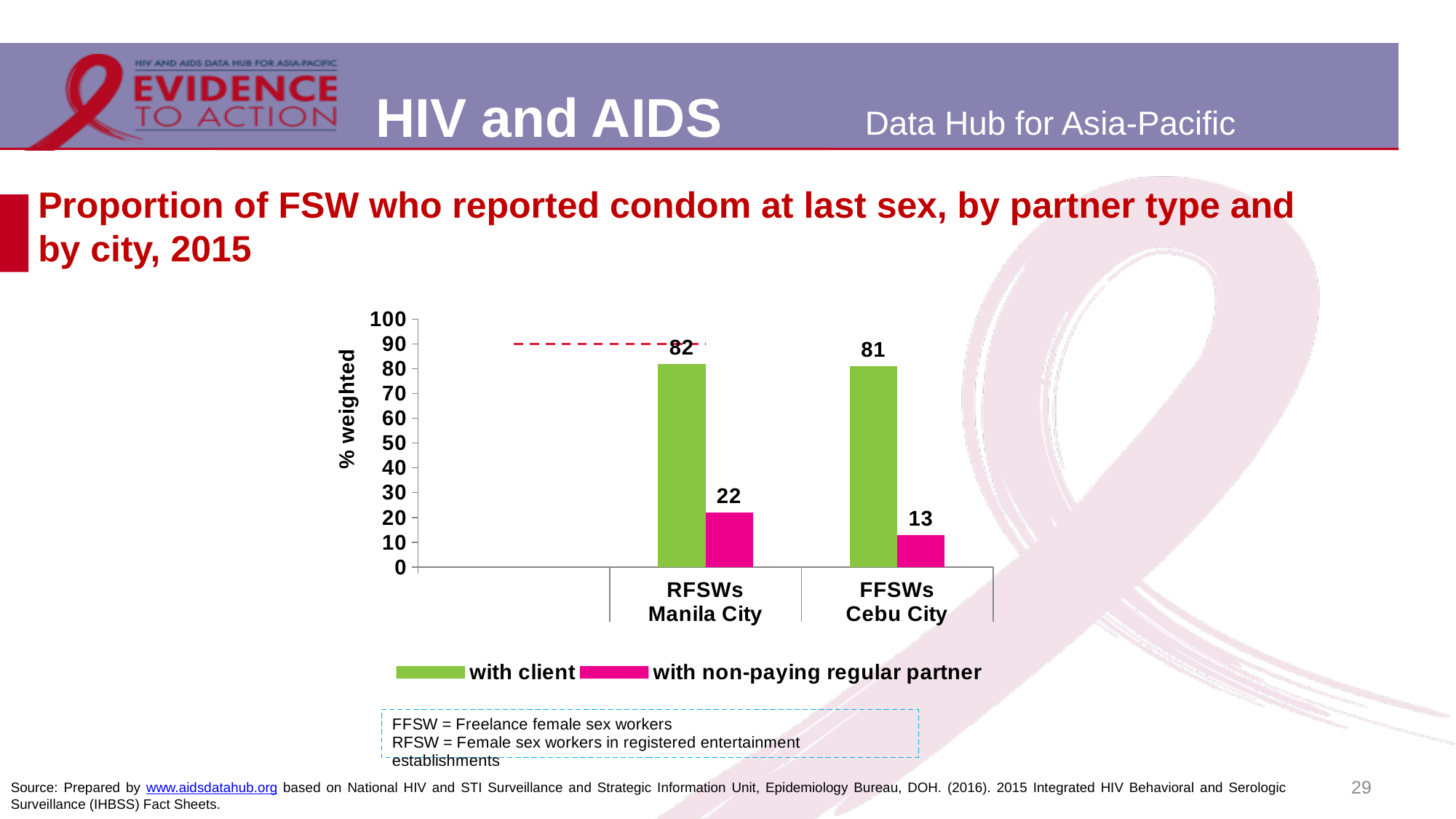
How many series does the legend list? 2 What is the value for 'with client' for RFSWs Manila City? 82 Is the 'with client' value for FFSWs Cebu City greater or less than 90? less What is the difference between the 'with non-paying regular partner' values for RFSWs Manila City and FFSWs Cebu City? 9 What is the value for 'with non-paying regular partner' for FFSWs Cebu City? 13 Which category has the lowest value for 'with non-paying regular partner'? FFSWs Cebu City How many categories are shown on the x axis? 2 Which is larger: the 'with non-paying regular partner' value for RFSWs Manila City or for FFSWs Cebu City? RFSWs Manila City What kind of chart is shown on the slide? bar chart What is the value for 'with non-paying regular partner' for RFSWs Manila City? 22 What is the difference between the 'with client' and 'with non-paying regular partner' values for RFSWs Manila City? 60 What is the value for 'with client' for FFSWs Cebu City? 81